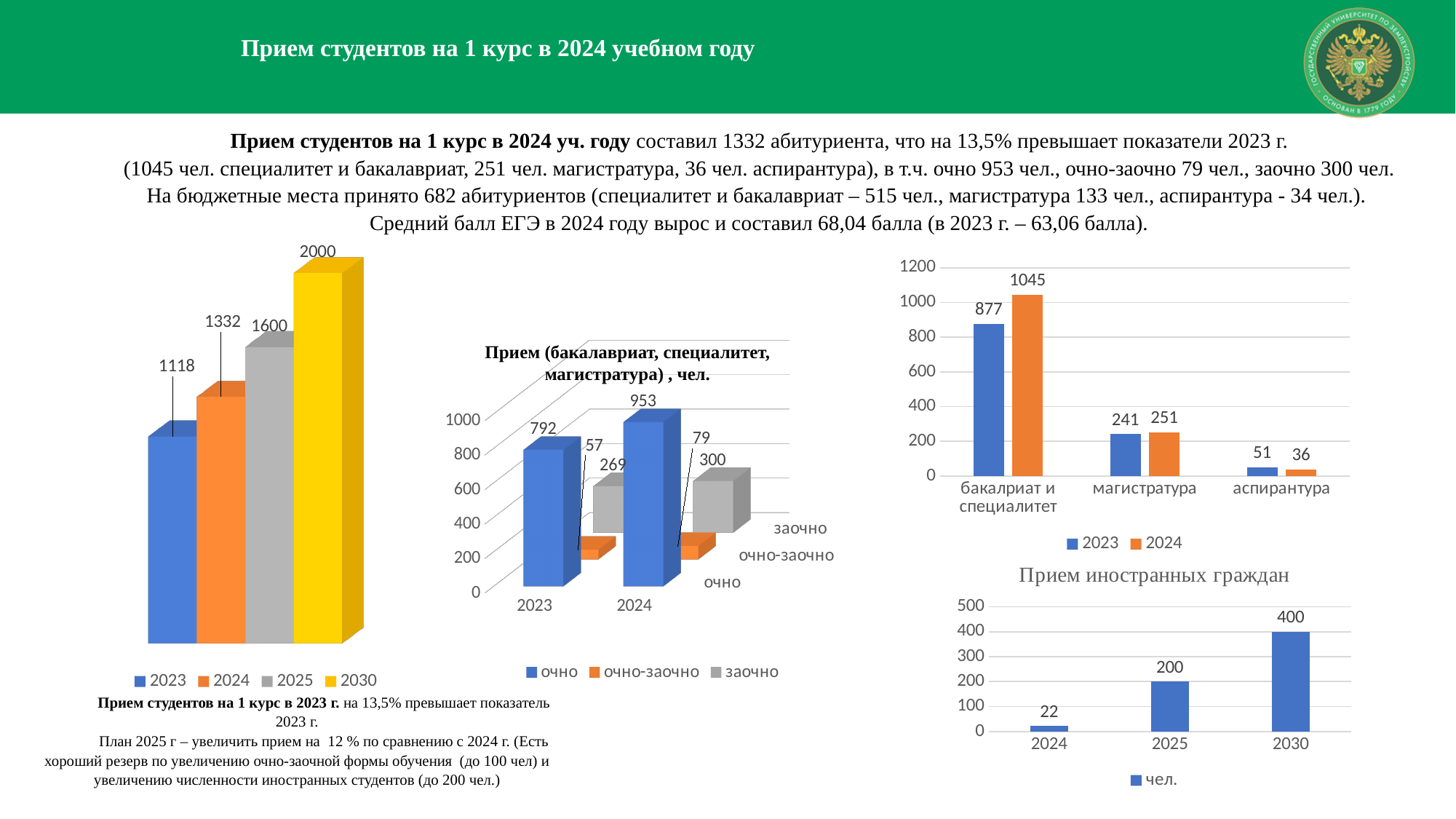
In the top-right chart with categories бакалриат и специалитет, магистратура and аспирантура, which is larger for аспирантура: the 2023 value or the 2024 value? 2023 In the chart titled "Прием иностранных граждан", which year has the lowest value? 2024 In the chart titled "Прием иностранных граждан", do the values rise or fall from 2024 to 2030? rise In the chart titled "Прием иностранных граждан", what is the difference between the values for 2030 and 2025? 200 In the top-right chart with categories бакалриат и специалитет, магистратура and аспирантура, how many series does the legend list? 2 In the leftmost chart with legend entries 2023, 2024, 2025 and 2030, how many bars are plotted? 4 In the top-right chart with categories бакалриат и специалитет, магистратура and аспирантура, what is the difference between the 2024 and 2023 values for бакалриат и специалитет? 168 In the leftmost chart with legend entries 2023, 2024, 2025 and 2030, what is the value for 2025? 1600 In the top-right chart with categories бакалриат и специалитет, магистратура and аспирантура, what is the 2024 value for магистратура? 251 In the chart titled "Прием (бакалавриат, специалитет, магистратура), чел.", what is the value for очно in 2024? 953 In the chart titled "Прием иностранных граждан", what is the value for 2030? 400 In the chart titled "Прием (бакалавриат, специалитет, магистратура), чел.", what is the value for заочно in 2023? 269